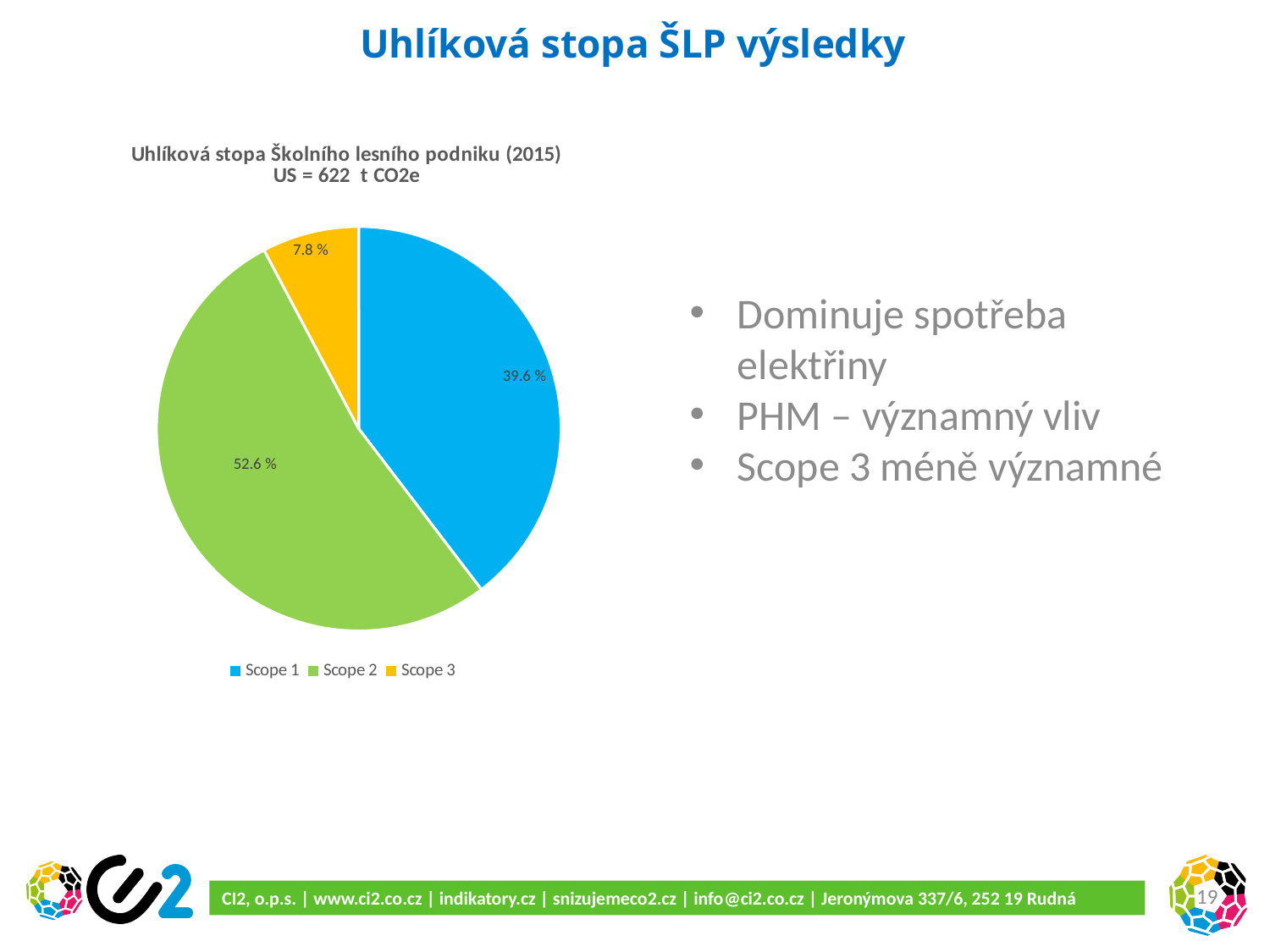
What share of the pie does Scope 1 represent? 39.6 % What kind of chart is shown on the slide? pie chart What is the title of the chart? Uhlíková stopa Školního lesního podniku (2015) US = 622 t CO2e What share of the pie does Scope 2 represent? 52.6 % How many entries does the legend list? 3 How many slices does the pie chart have? 3 What share of the pie does Scope 3 represent? 7.8 % What is the difference in percentage points between the Scope 2 share and the Scope 1 share? 13.0 % Which scope has the smallest slice of the pie? Scope 3 Which scope has the largest slice of the pie? Scope 2 Which is larger, the share for Scope 1 or the share for Scope 3? Scope 1 What colour is the Scope 3 slice? yellow